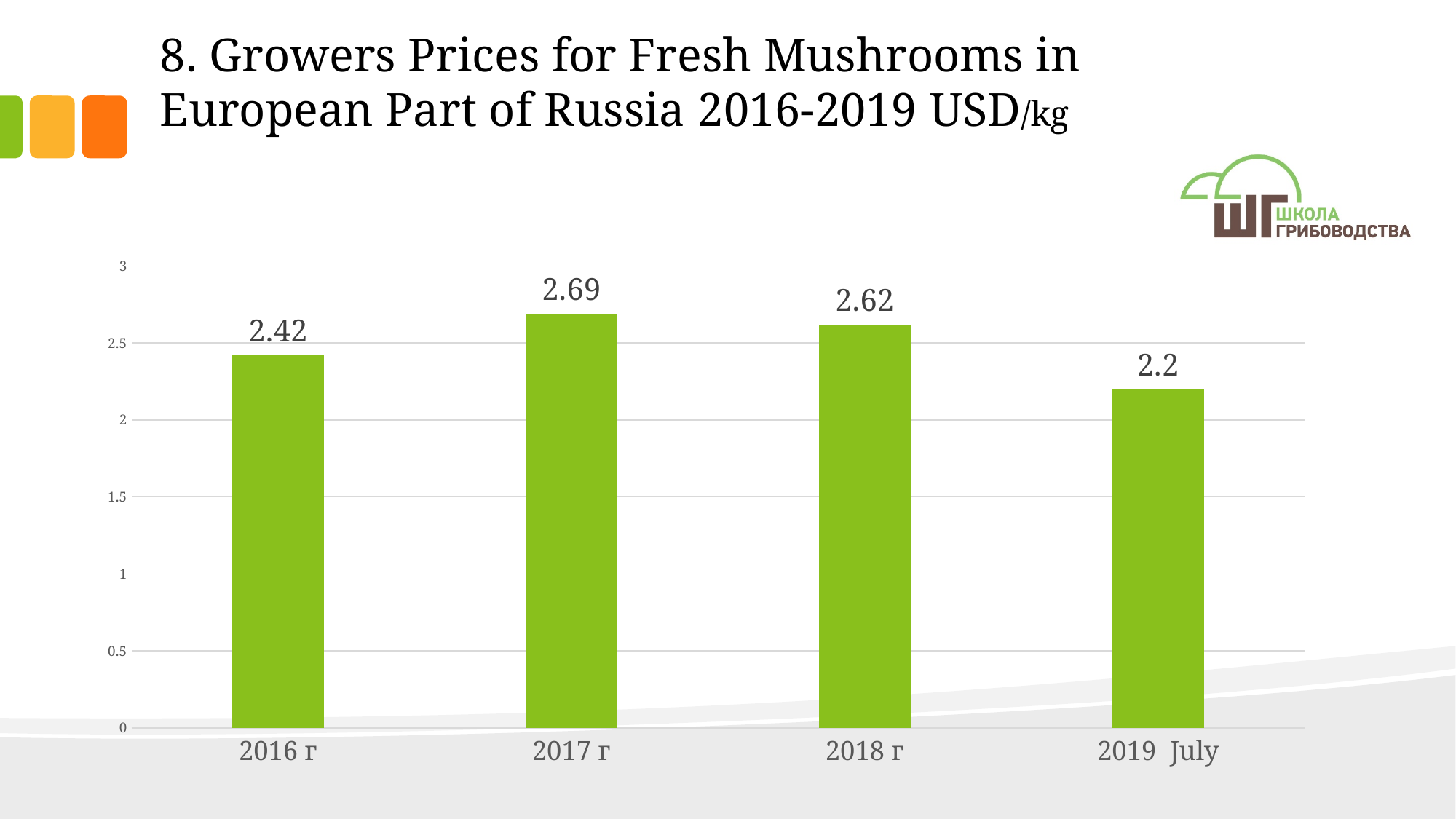
What is the growers price for fresh mushrooms in 2018 г? 2.62 What is the difference between the growers price in 2017 г and 2019 July? 0.49 What is the growers price for fresh mushrooms in 2017 г? 2.69 Which period has the lowest growers price? 2019 July Is the growers price for 2019 July greater or less than 2.5? less What is the difference between the growers price in 2017 г and 2016 г? 0.27 What is the growers price for fresh mushrooms in 2019 July? 2.2 Which is larger, the growers price in 2016 г or in 2018 г? 2018 г Which period has the highest growers price? 2017 г What kind of chart is shown on the slide? bar chart How many periods are shown on the chart? 4 What is the growers price for fresh mushrooms in 2016 г? 2.42